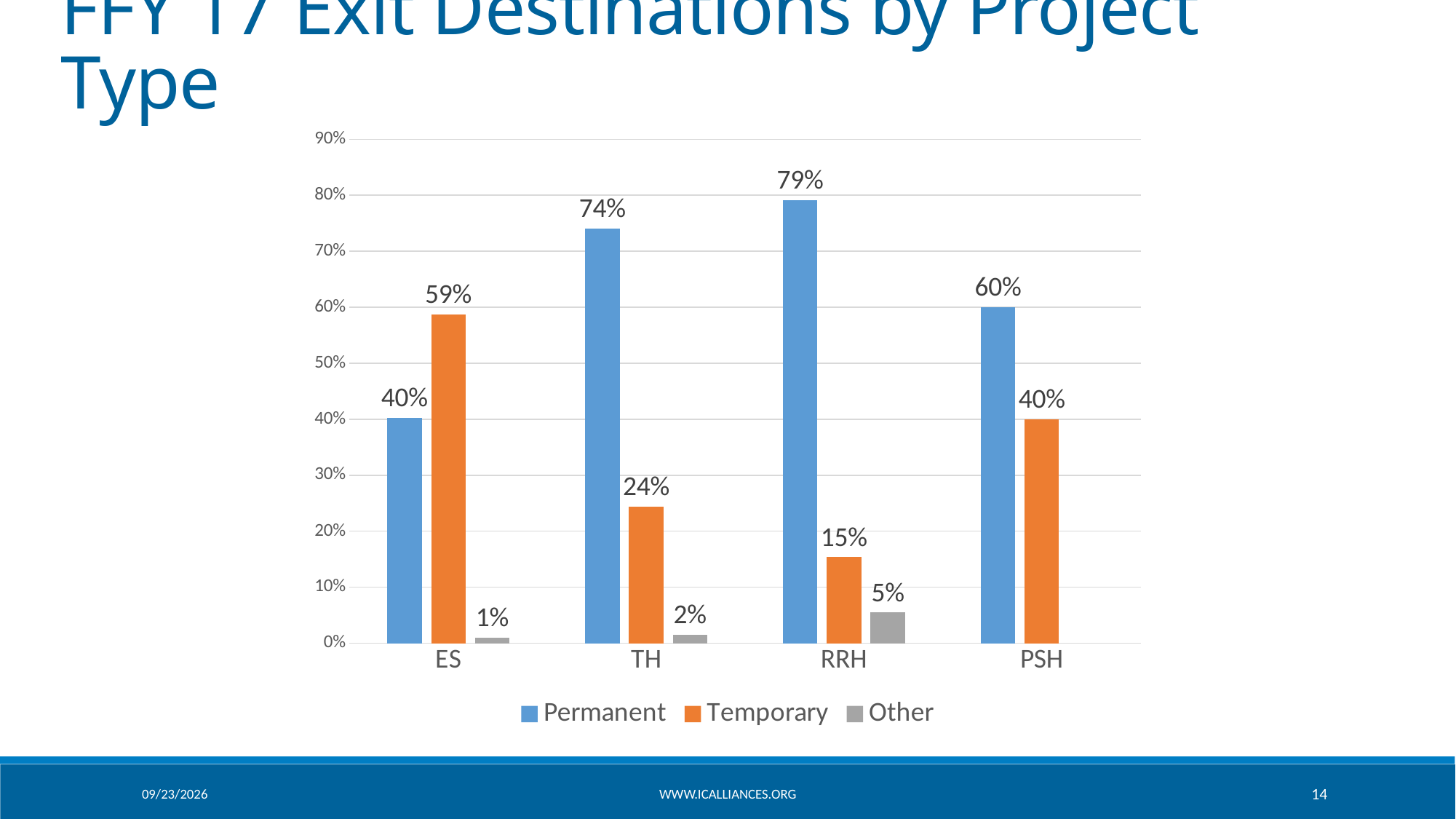
What is the difference between the Permanent values for TH and ES? 34% How many series does the legend list? 3 What kind of chart is shown on the slide? Bar chart What is the Temporary value for PSH? 40% Which series is shown in orange? Temporary What is the Permanent value for RRH? 79% Which is larger for ES, the Permanent value or the Temporary value? Temporary Which project type has the highest Permanent value? RRH What is the Temporary value for ES? 59% Which project type has the lowest Temporary value? RRH How many project types are shown on the x axis? 4 What is the Other value for RRH? 5%